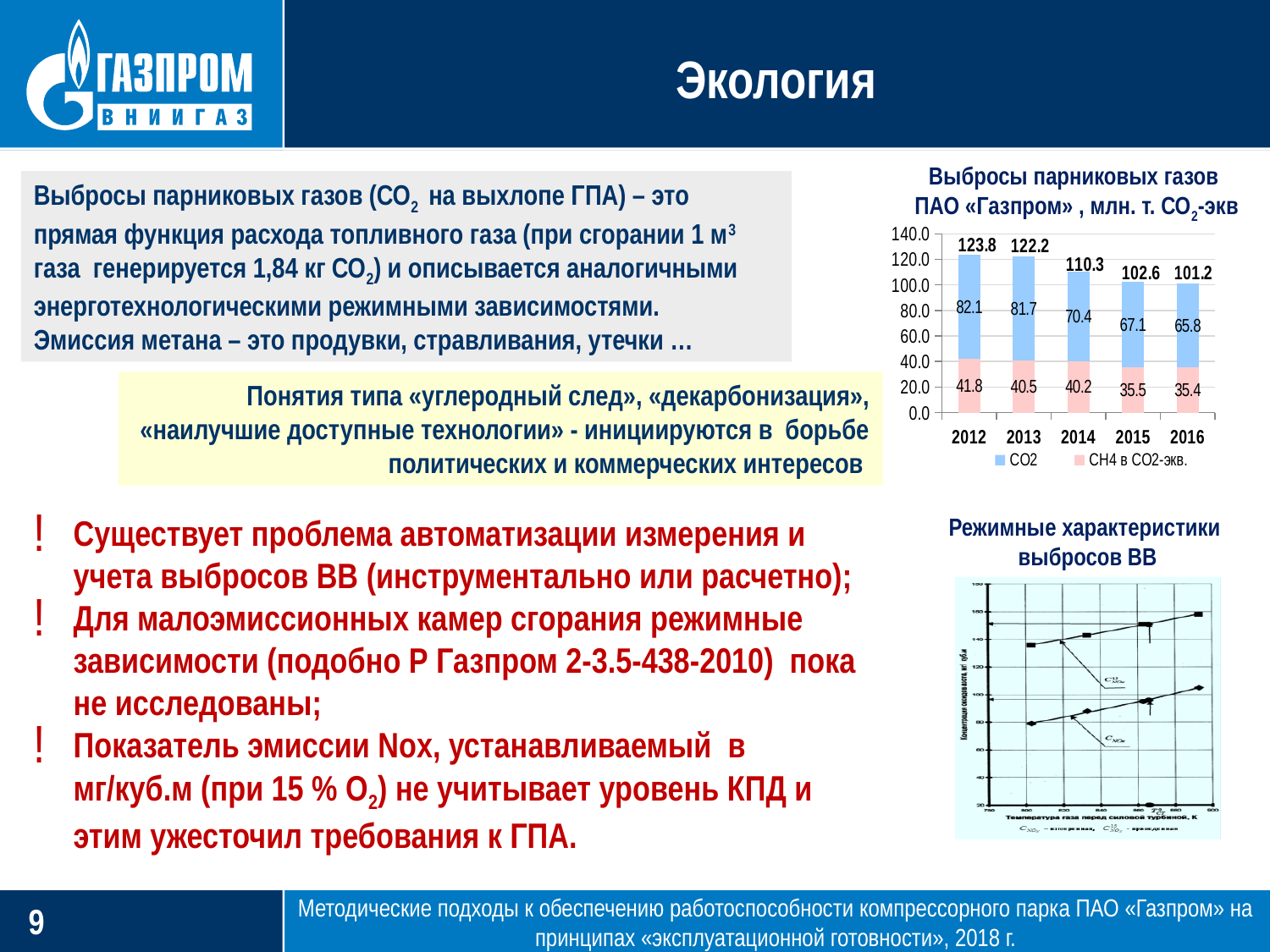
In the chart «Выбросы парниковых газов ПАО «Газпром»», which is larger: the CO2 value for 2013 or the CO2 value for 2014? 2013 In the chart «Выбросы парниковых газов ПАО «Газпром»», which year has the highest total emissions? 2012 In the chart «Выбросы парниковых газов ПАО «Газпром»», which year has the lowest CO2 value? 2016 What kind of chart is «Выбросы парниковых газов ПАО «Газпром»»? stacked bar chart How many series does the legend of the chart «Выбросы парниковых газов ПАО «Газпром»» list? 2 In the chart «Выбросы парниковых газов ПАО «Газпром»», is the total for 2015 greater or less than 100.0? greater In the chart «Выбросы парниковых газов ПАО «Газпром»», what is the total of the stacked bar for 2014? 110.3 How many years are shown on the x axis of the chart «Выбросы парниковых газов ПАО «Газпром»»? 5 In the chart «Выбросы парниковых газов ПАО «Газпром»», do the total emissions rise or fall from 2012 to 2016? fall In the chart «Выбросы парниковых газов ПАО «Газпром»», what is the difference between the total for 2012 and the total for 2016? 22.6 In the chart «Выбросы парниковых газов ПАО «Газпром»», what is the CH4 в CO2-экв. value for 2015? 35.5 In the chart «Выбросы парниковых газов ПАО «Газпром»», what is the CO2 value for 2012? 82.1